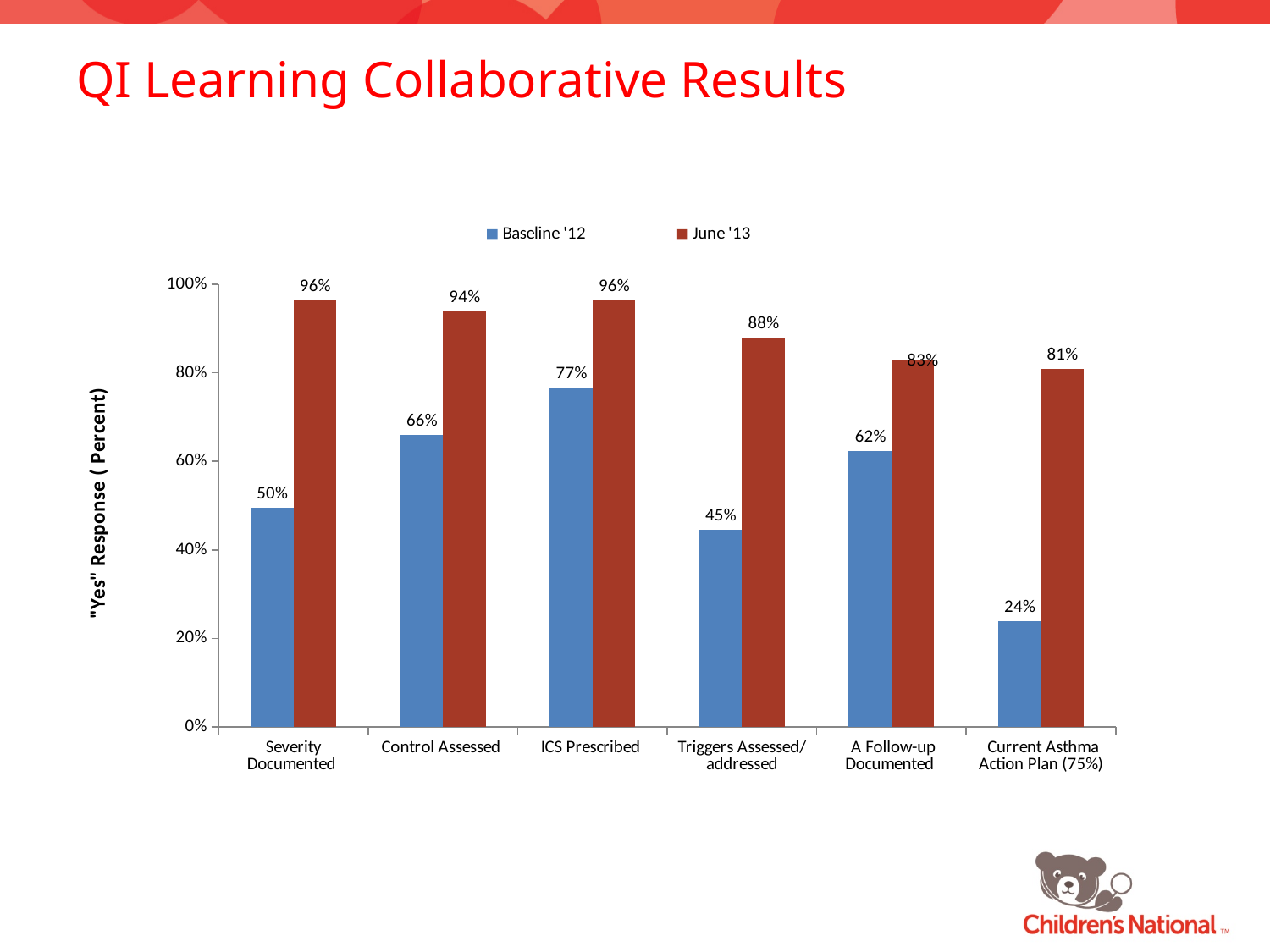
What kind of chart is shown on the slide? Bar chart What is the Baseline '12 value for Current Asthma Action Plan (75%)? 24% How many categories are shown on the x axis? 6 What is the Baseline '12 value for Severity Documented? 50% What is the June '13 value for Triggers Assessed/addressed? 88% How many series does the legend list? 2 Which is larger: the Baseline '12 value for Control Assessed or the Baseline '12 value for A Follow-up Documented? Control Assessed Is the June '13 value for A Follow-up Documented greater or less than 80%? greater Which category has the lowest June '13 value? Current Asthma Action Plan (75%) Which category has the highest Baseline '12 value? ICS Prescribed What is the difference between the June '13 and Baseline '12 values for Severity Documented? 46% What is the June '13 value for Control Assessed? 94%